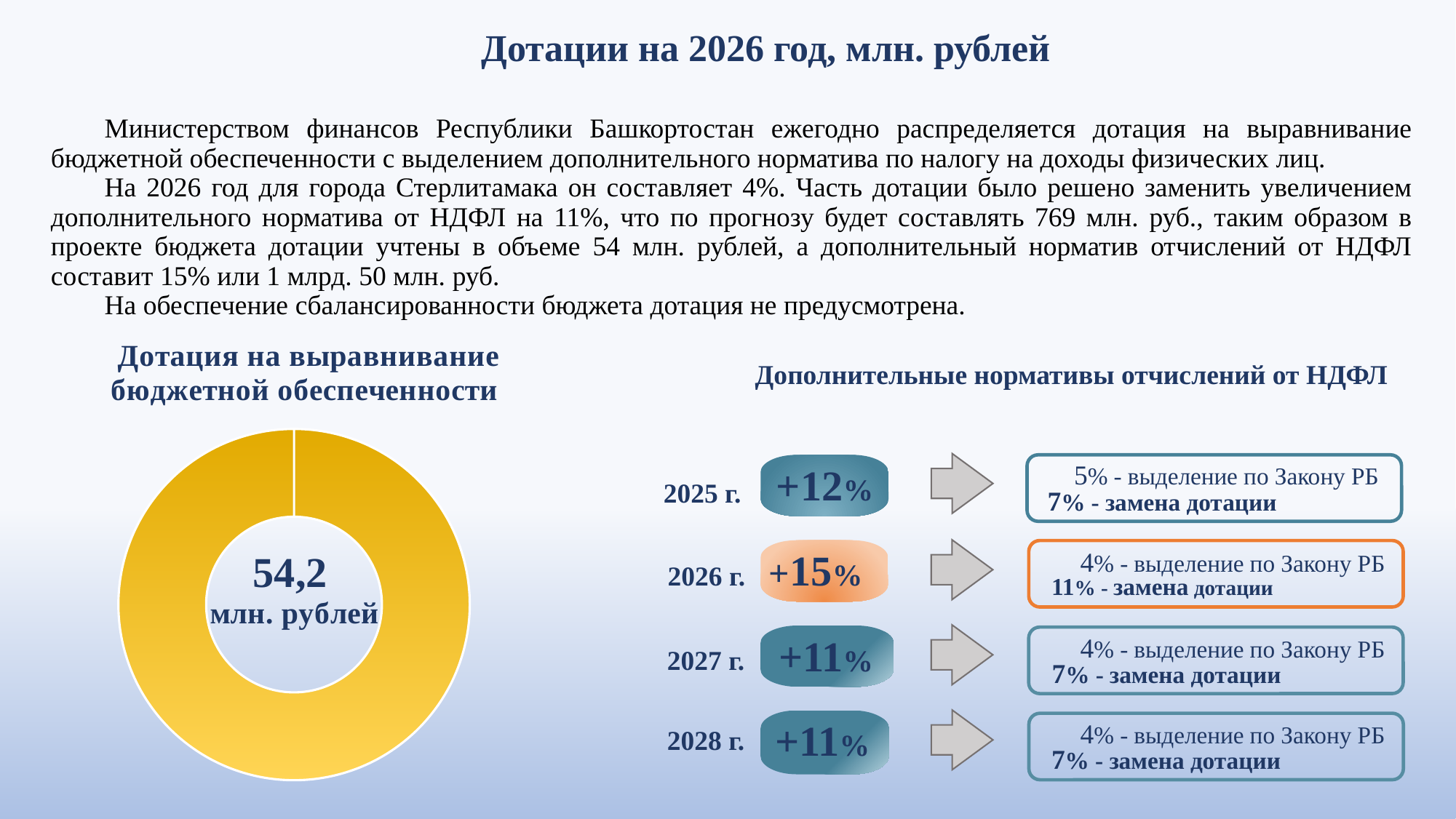
In the diagram "Дополнительные нормативы отчислений от НДФЛ", how many years are listed? 4 What is the title of the doughnut chart on the left of the slide? Дотация на выравнивание бюджетной обеспеченности In the diagram "Дополнительные нормативы отчислений от НДФЛ", what share is marked as "замена дотации" for 2026 г.? 11% In the diagram "Дополнительные нормативы отчислений от НДФЛ", which year has the highest percentage? 2026 г. What kind of chart is shown under the title "Дотация на выравнивание бюджетной обеспеченности"? Doughnut chart In the diagram "Дополнительные нормативы отчислений от НДФЛ", what is the difference between the percentages for 2026 г. and 2027 г.? 4% In the diagram "Дополнительные нормативы отчислений от НДФЛ", what percentage is shown for 2026 г.? +15% What colour is the ring of the doughnut chart on the left of the slide? Yellow What value is printed in the centre of the doughnut chart "Дотация на выравнивание бюджетной обеспеченности"? 54,2 млн. рублей How many slices does the doughnut chart on the left of the slide have? 1 In the diagram "Дополнительные нормативы отчислений от НДФЛ", what percentage is shown for 2025 г.? +12%